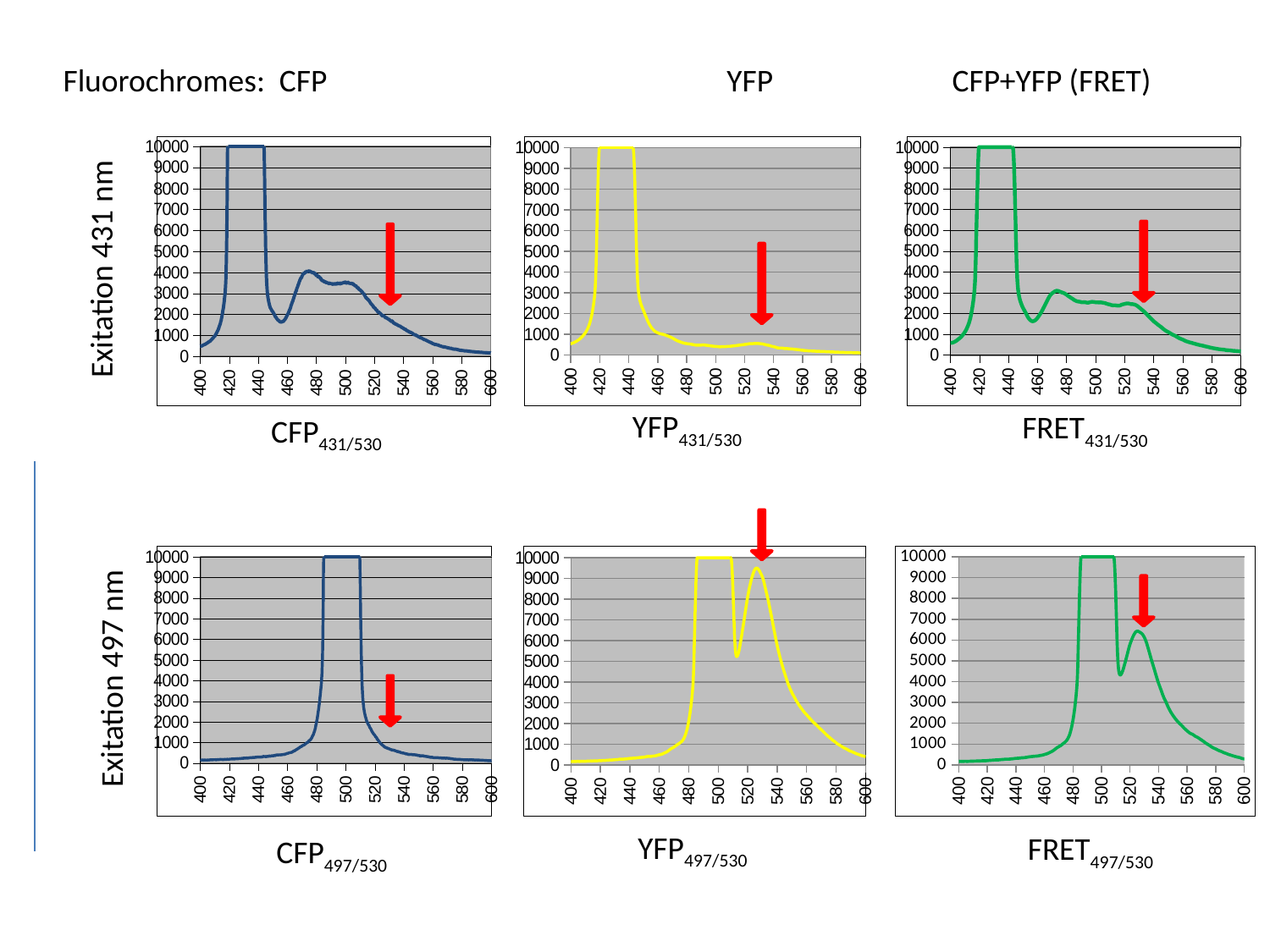
In the YFP 431/530 chart (top middle), is the value at 530 nm greater or less than 1000? less In the FRET 497/530 chart (bottom right), is the value at 530 nm greater or less than 5000? greater At 530 nm, which is larger: the value in the CFP 431/530 chart (top left) or the value in the YFP 431/530 chart (top middle)? CFP 431/530 In the CFP 497/530 chart (bottom left), is the value at 500 nm greater or less than 9000? greater At 530 nm, which is larger: the value in the YFP 497/530 chart (bottom middle) or the value in the FRET 497/530 chart (bottom right)? YFP 497/530 How many charts are shown on the slide? 6 In the CFP 497/530 chart (bottom left), do the values rise or fall from 520 nm to 600 nm? fall What kind of chart is the CFP 431/530 chart (top left)? line chart What colour is the line in the FRET 431/530 and FRET 497/530 charts? green